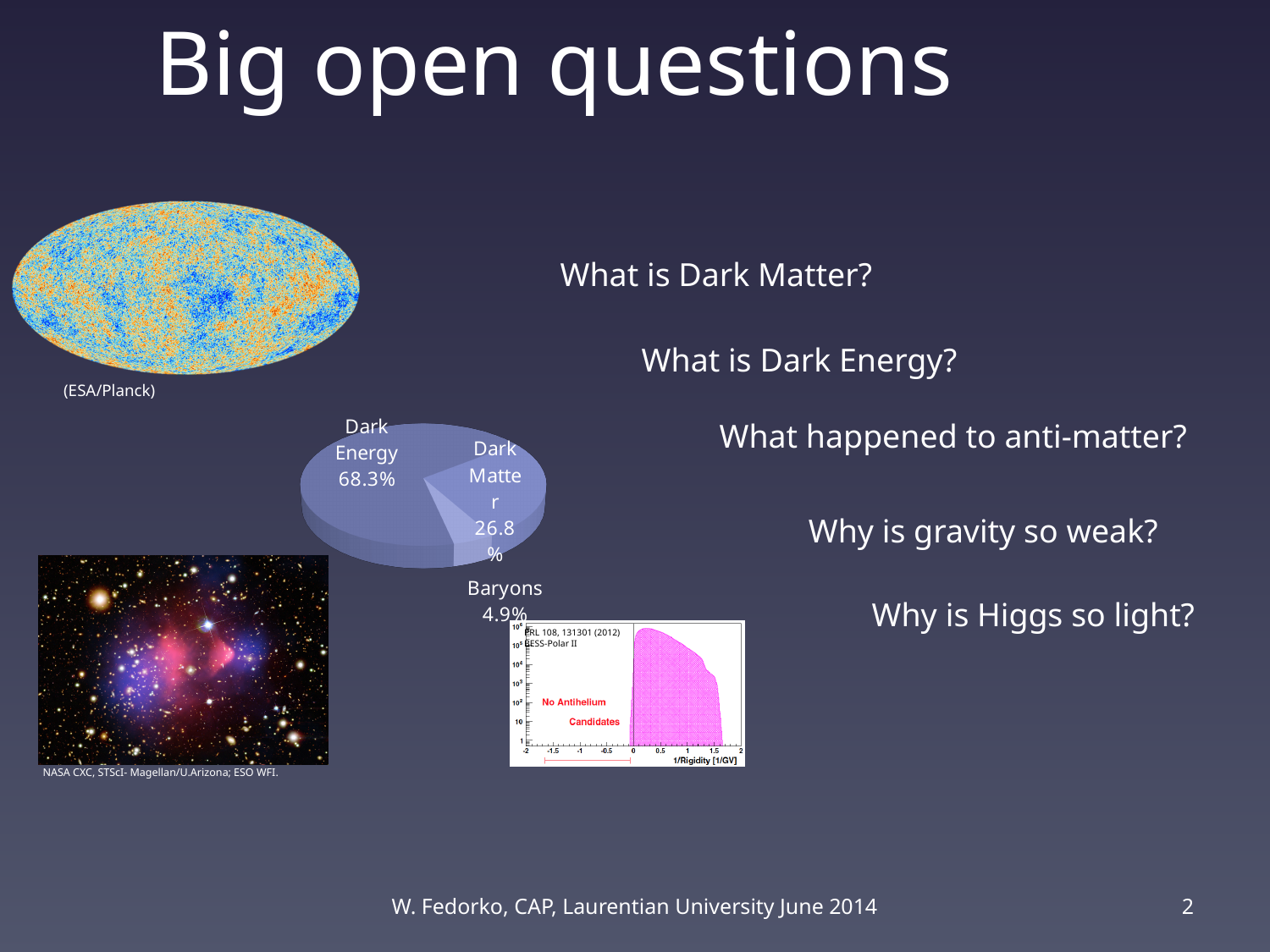
What percentage does the pie chart show for Dark Matter? 26.8% How many slices does the pie chart have? 3 In the pie chart, which is larger: Dark Matter or Baryons? Dark Matter What percentage does the pie chart show for Dark Energy? 68.3% What is the difference between the Dark Energy and Dark Matter percentages in the pie chart? 41.5% Which slice of the pie chart is the largest? Dark Energy What kind of chart is used to show the Dark Energy, Dark Matter and Baryons breakdown? Pie chart What share of the pie chart does Dark Matter represent? 26.8% What is the difference between the Dark Matter and Baryons percentages in the pie chart? 21.9% What percentage does the pie chart show for Baryons? 4.9% Which slice of the pie chart is the smallest? Baryons What is the combined percentage of Dark Matter and Baryons in the pie chart? 31.7%